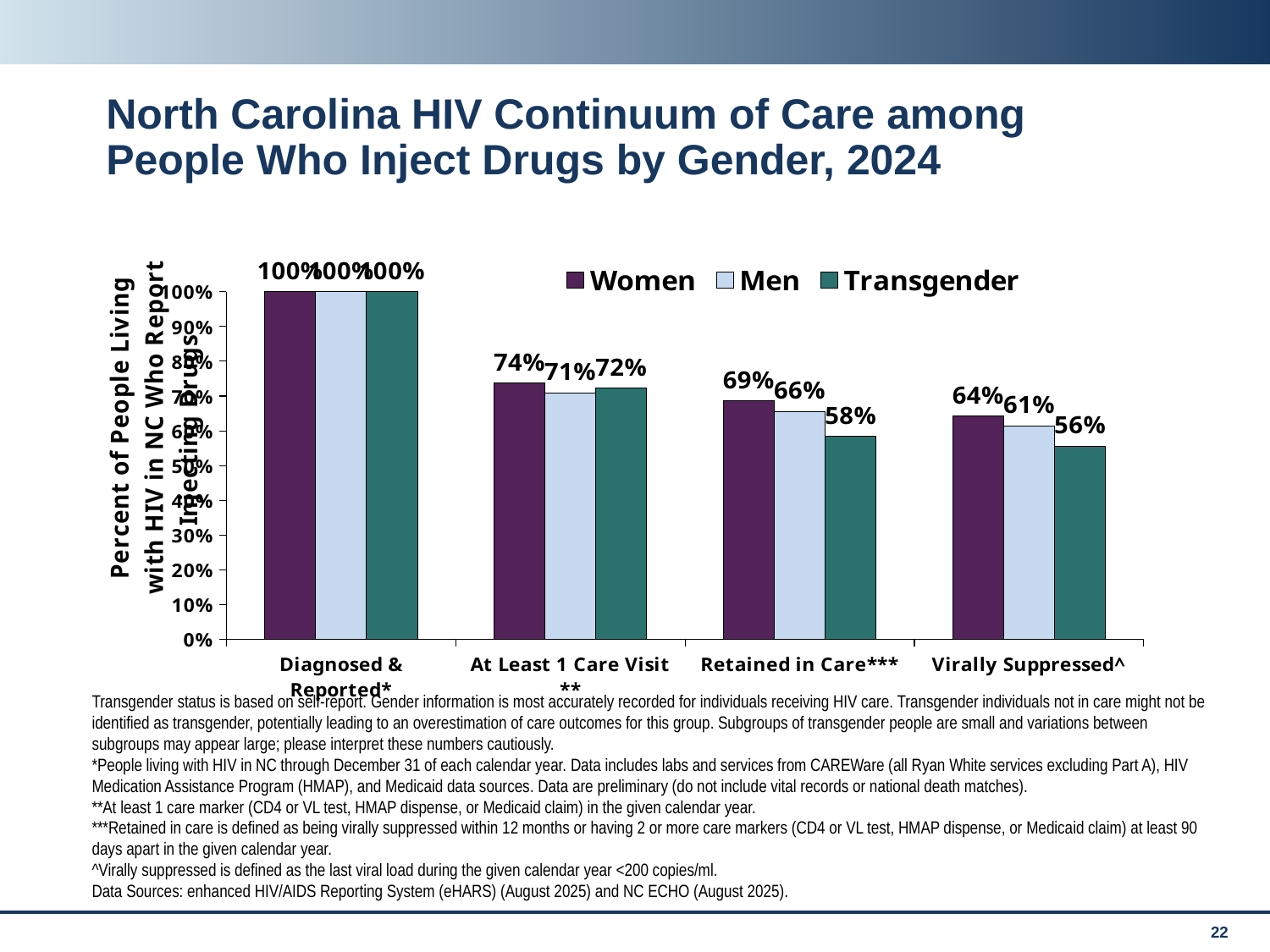
Which series has the highest value in the Virally Suppressed^ category? Women What is the value for Men in the At Least 1 Care Visit** category? 71% Do the values for Women rise or fall from Diagnosed & Reported* to Virally Suppressed^? Fall How many series does the legend list? 3 What kind of chart is shown on the slide? Bar chart What are the three series listed in the legend? Women, Men, Transgender What is the difference between the Women and Transgender values in the Retained in Care*** category? 11% How many categories are shown on the x axis? 4 Which is larger in the At Least 1 Care Visit** category: the value for Men or the value for Transgender? Transgender Which series has the lowest value in the Retained in Care*** category? Transgender What is the value for Women in the Retained in Care*** category? 69% What is the value for Transgender in the Virally Suppressed^ category? 56%